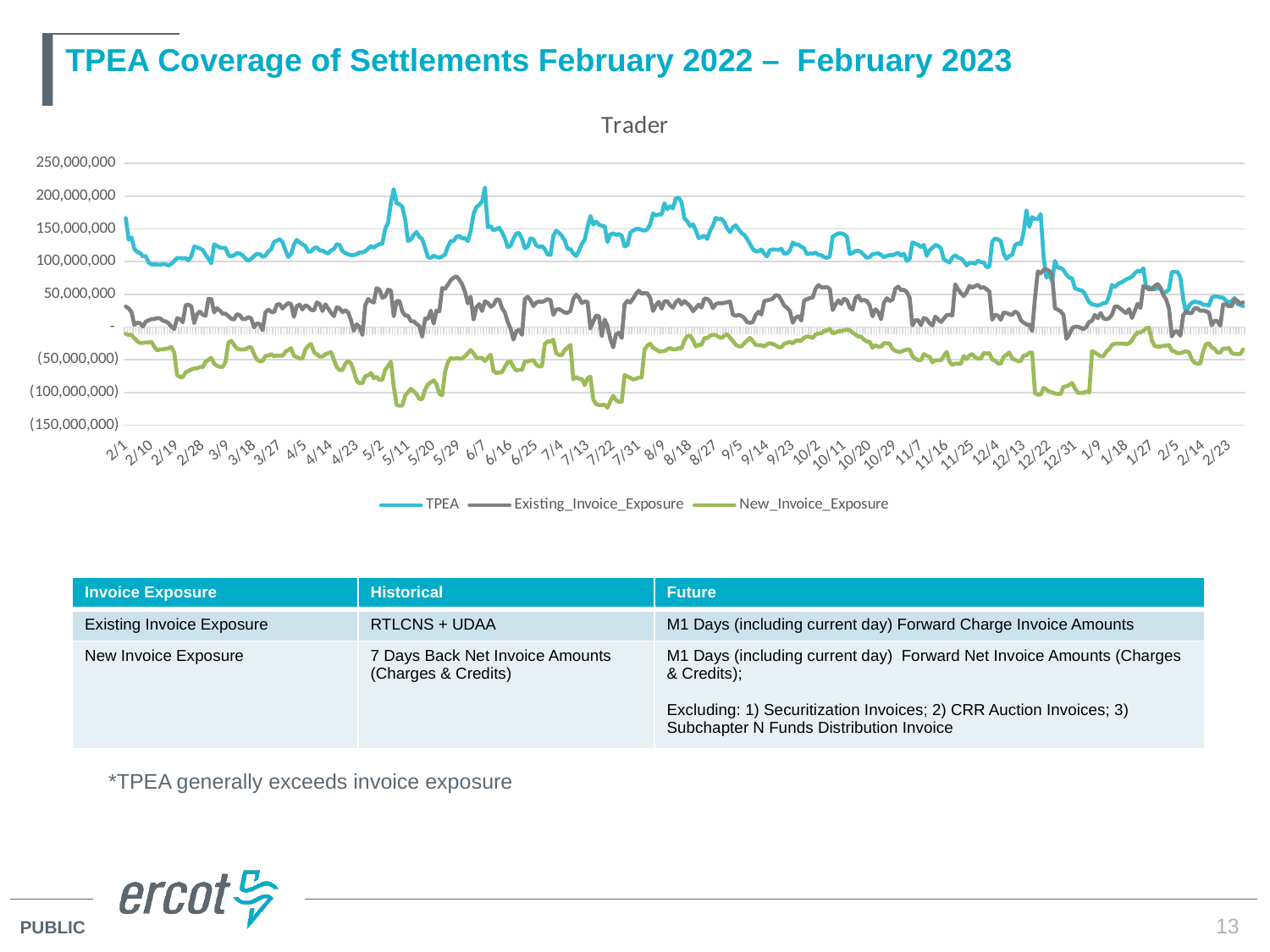
Is the TPEA value on 2/23 greater or less than 100,000,000? less Which is larger on 2/1: the TPEA value or the Existing_Invoice_Exposure value? TPEA Which series has the highest values across the whole chart? TPEA What is the title of the chart? Trader What kind of chart is shown on the slide? line chart Which series has the lowest values across the whole chart? New_Invoice_Exposure Overall, does the TPEA line rise or fall from 2/1 to 2/23 along the x axis? fall Which series is drawn in green in the chart? New_Invoice_Exposure Is the Existing_Invoice_Exposure value on 12/13 greater or less than 50,000,000? less How many series does the chart legend list? 3